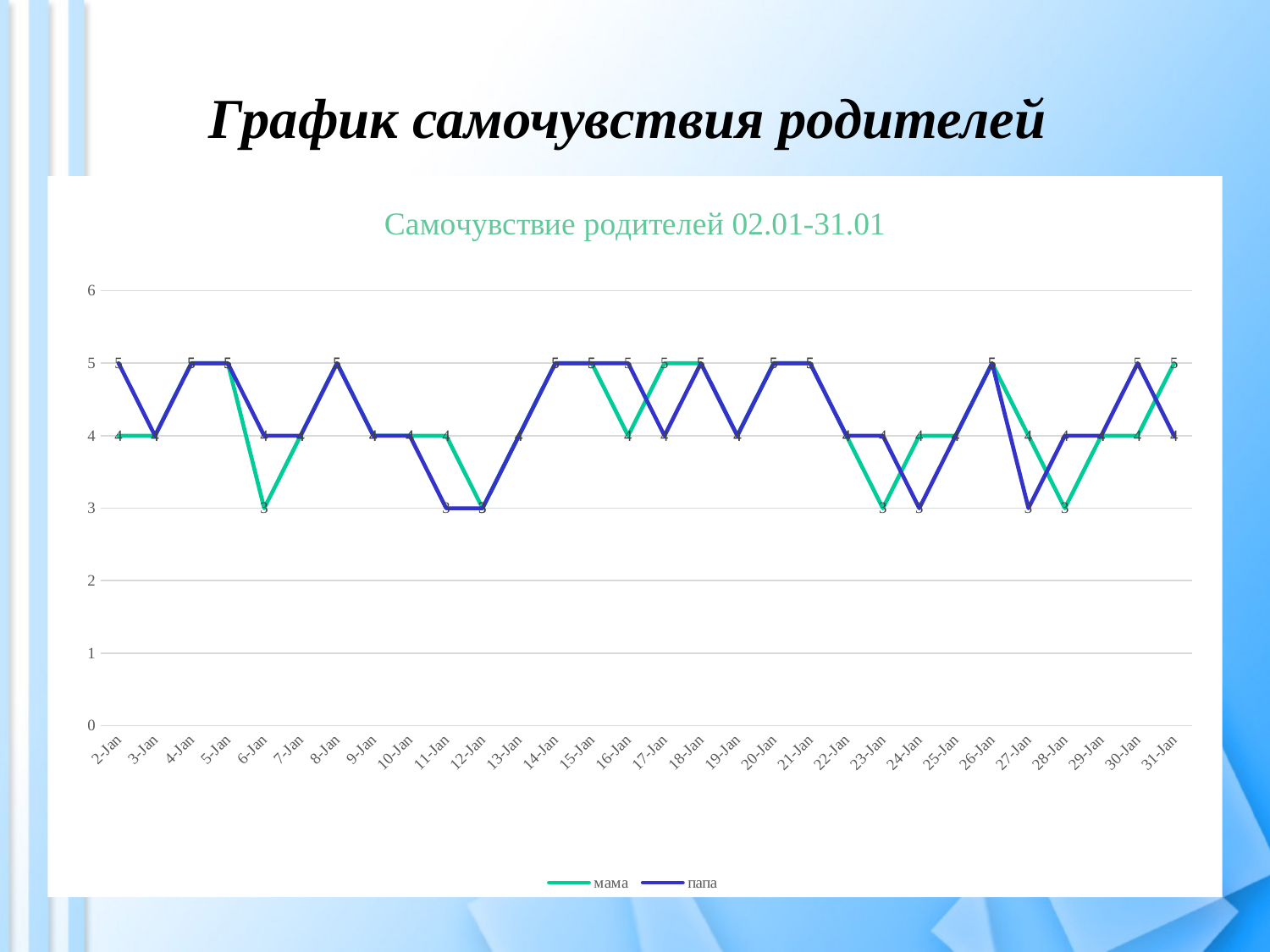
What are the names of the two series in the legend? мама and папа What is the lowest value reached by the папа series? 3 Which series has the higher value on 16-Jan, мама or папа? папа How many series does the legend list? 2 What is the value for папа on 11-Jan? 3 What is the value for папа on 2-Jan? 5 What is the title of the chart? Самочувствие родителей 02.01-31.01 What kind of chart is shown on the slide? line chart What is the difference between the мама and папа values on 23-Jan? 1 What is the value for мама on 6-Jan? 3 How many dates are plotted along the x axis? 30 What is the value for мама on 17-Jan? 5